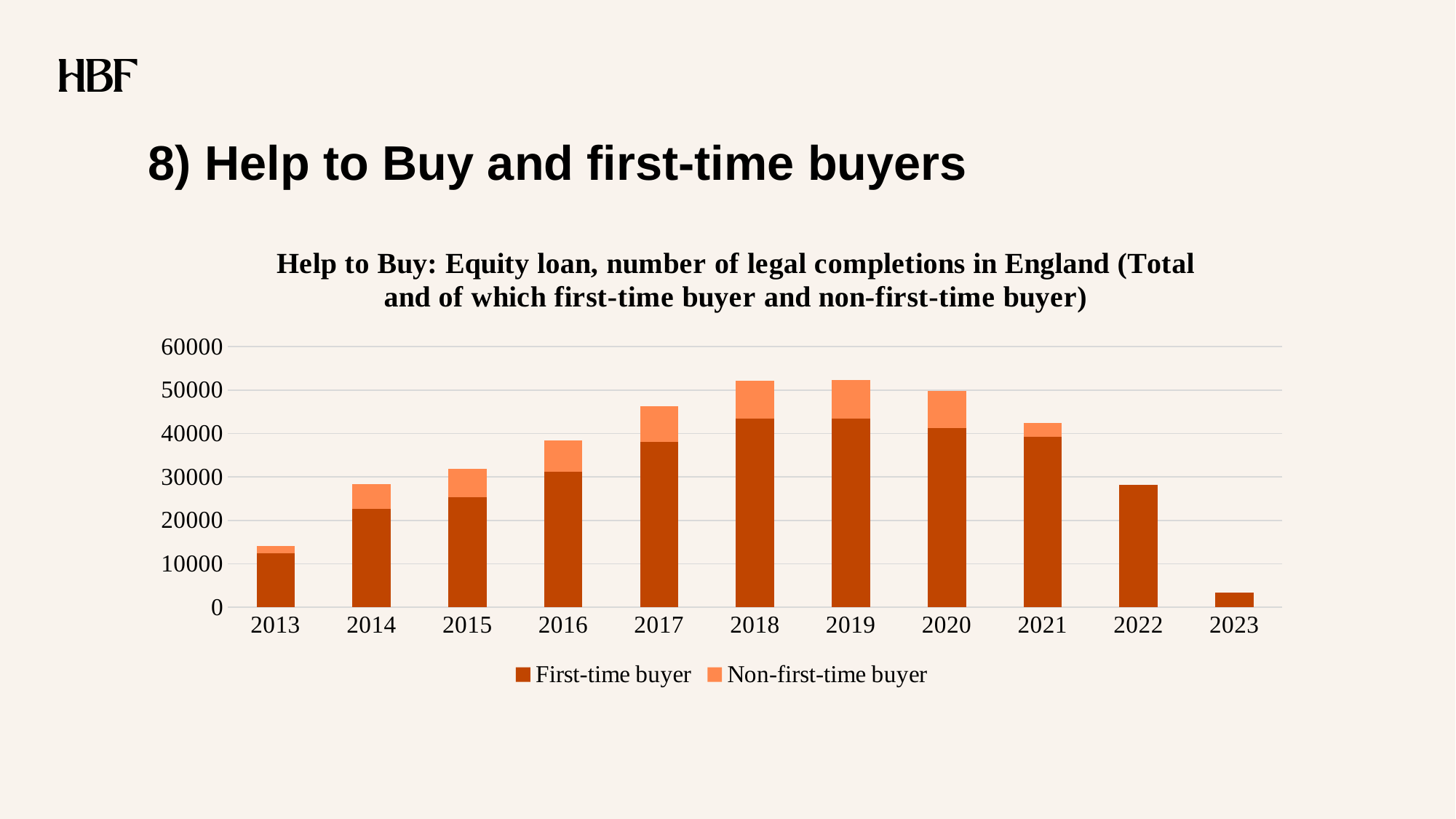
Is the total number of completions in 2017 greater or less than 40000? greater Which year has the lowest total number of legal completions? 2023 Is the value for 2023 greater or less than 10000? less Do the total completions rise or fall from 2019 to 2023? Fall Is the total number of completions in 2013 greater or less than 20000? less How many series does the legend list? 2 What kind of chart is shown on the slide? Stacked bar chart How many years are shown on the x axis? 11 Which series is shown in the lighter orange colour? Non-first-time buyer Which year has the larger total number of completions, 2015 or 2016? 2016